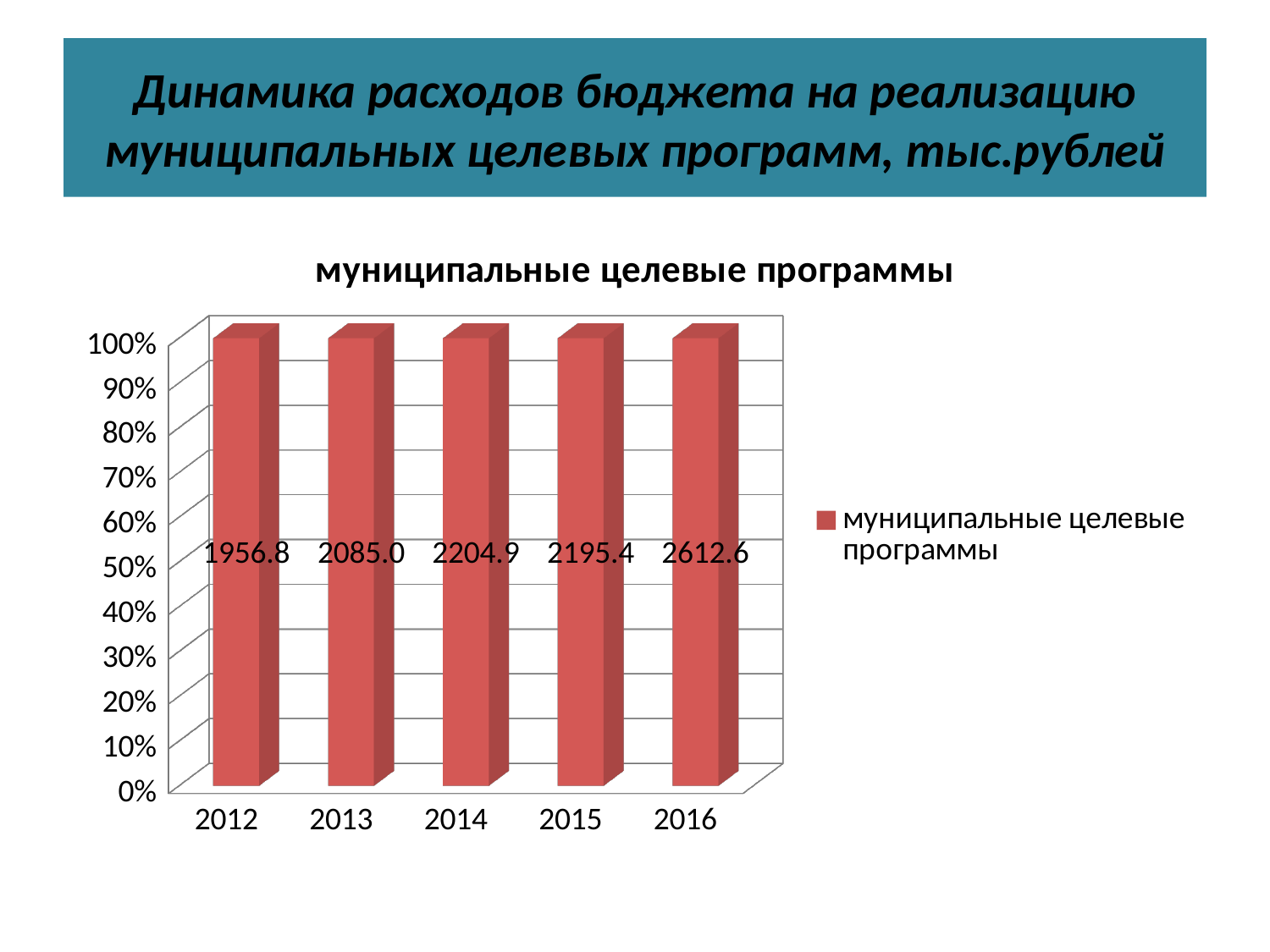
Which has the larger labelled value, 2014 or 2015? 2014 What is the data label shown for 2012? 1956.8 What is the difference between the labelled values for 2016 and 2012? 655.8 What is the data label shown for 2014? 2204.9 How many series does the legend list? 1 Which year has the highest labelled value? 2016 How many years are shown on the x axis? 5 What kind of chart is shown on the slide? Bar chart What is the data label shown for 2015? 2195.4 Which year has the lowest labelled value? 2012 What is the title of the chart? муниципальные целевые программы What is the data label shown for 2016? 2612.6